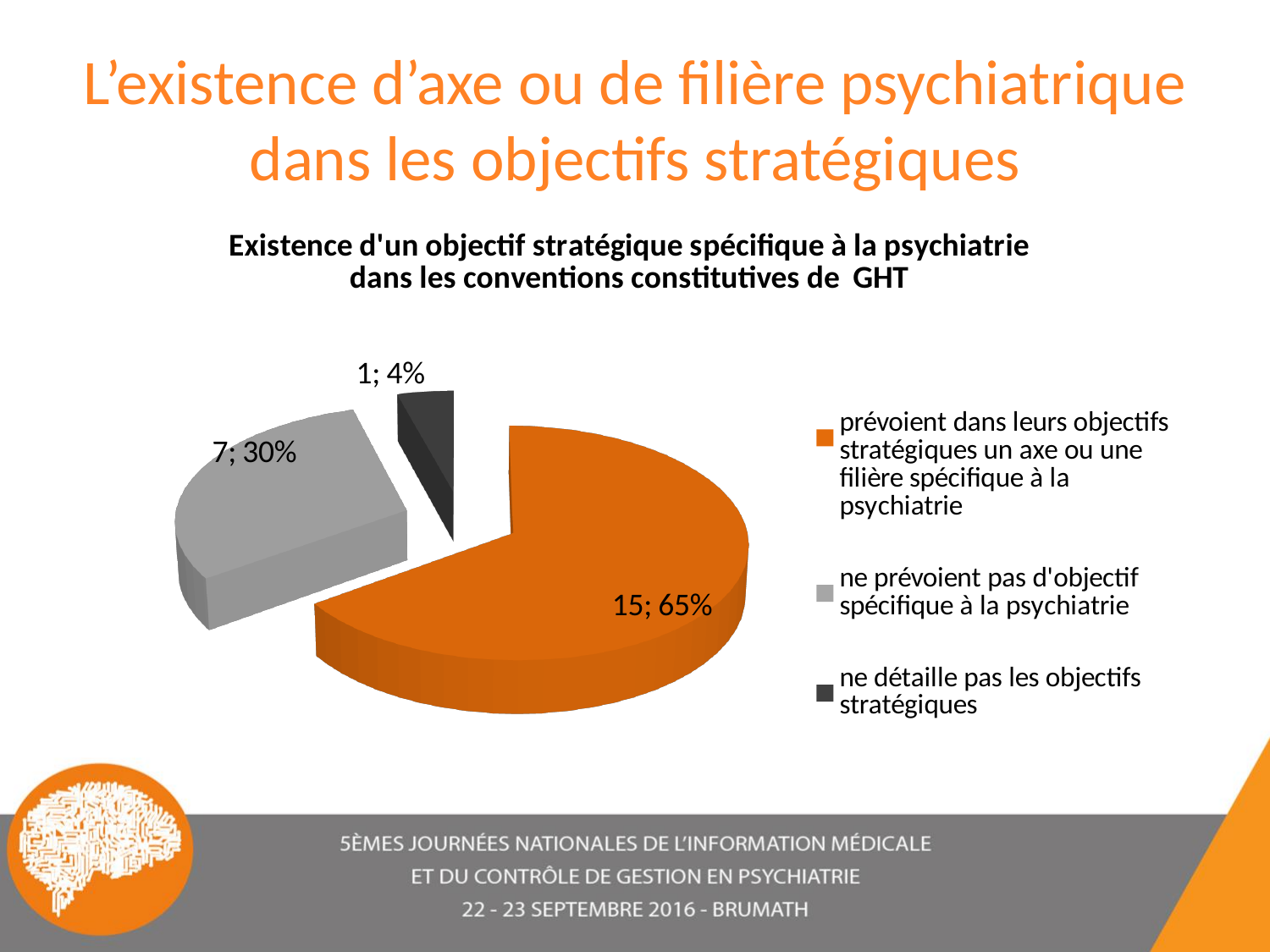
Which category has the smallest slice of the pie? ne détaille pas les objectifs stratégiques What colour is the slice for 'ne détaille pas les objectifs stratégiques'? dark grey What is the count for GHT that 'ne prévoient pas d'objectif spécifique à la psychiatrie'? 7 How many entries does the legend list? 3 What share of the pie is taken by 'ne prévoient pas d'objectif spécifique à la psychiatrie'? 30% What share of the pie is taken by 'prévoient dans leurs objectifs stratégiques un axe ou une filière spécifique à la psychiatrie'? 65% What is the count for GHT that 'prévoient dans leurs objectifs stratégiques un axe ou une filière spécifique à la psychiatrie'? 15 What is the count for GHT that 'ne détaille pas les objectifs stratégiques'? 1 What is the difference in count between 'prévoient dans leurs objectifs stratégiques un axe ou une filière spécifique à la psychiatrie' and 'ne prévoient pas d'objectif spécifique à la psychiatrie'? 8 What kind of chart is shown on the slide? pie chart Which category has the largest slice of the pie? prévoient dans leurs objectifs stratégiques un axe ou une filière spécifique à la psychiatrie How many slices does the pie chart have? 3